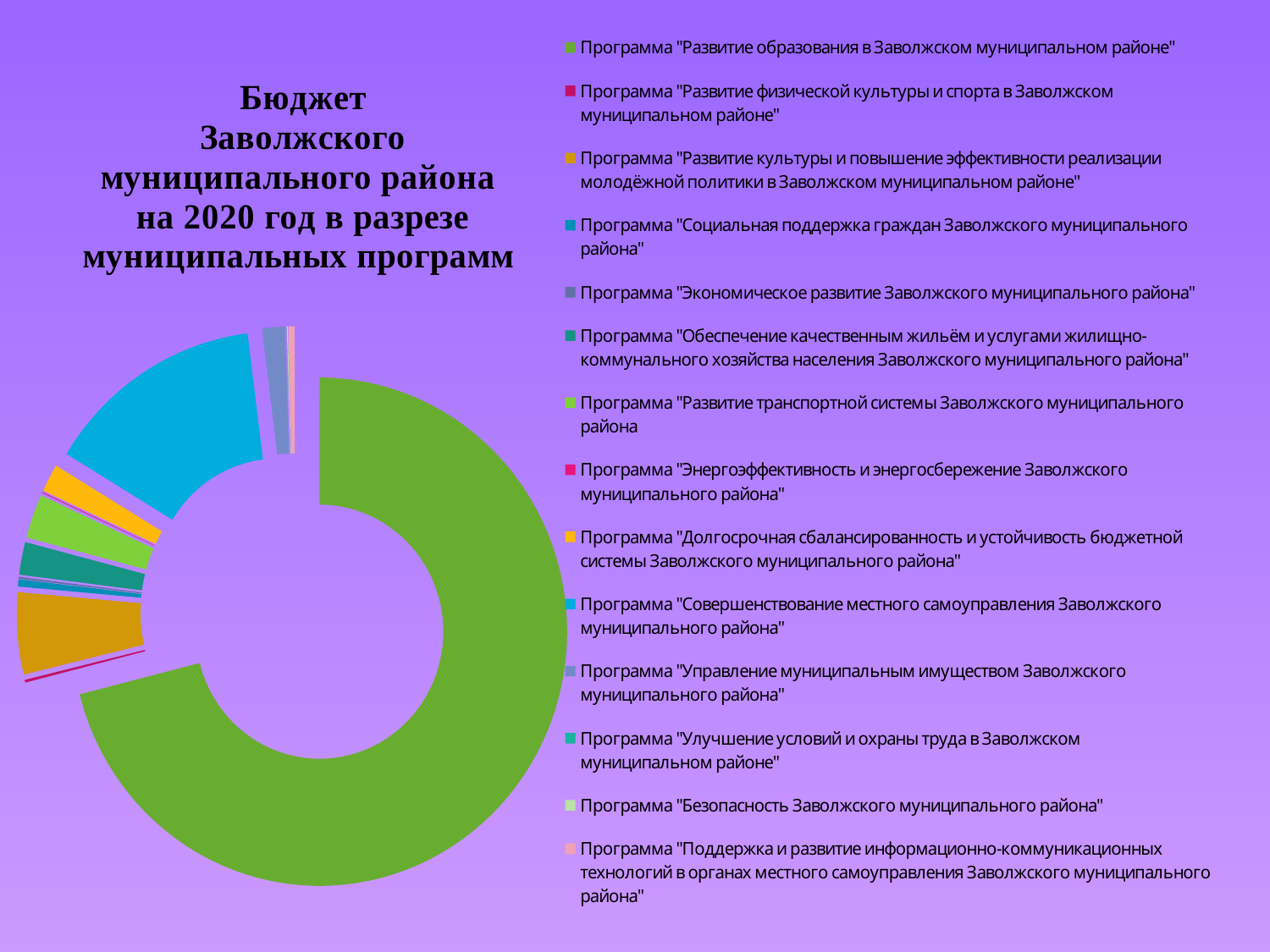
For which year does the chart show the budget? 2020 Which program is listed first in the legend? Программа "Развитие образования в Заволжском муниципальном районе" Which is larger: the share for Программа "Социальная поддержка граждан Заволжского муниципального района" or the share for Программа "Развитие культуры и повышение эффективности реализации молодёжной политики в Заволжском муниципальном районе"? Программа "Развитие культуры и повышение эффективности реализации молодёжной политики в Заволжском муниципальном районе" Which program is represented by the green colour in the chart? Программа "Развитие образования в Заволжском муниципальном районе" What kind of chart is shown on the slide? Doughnut (pie) chart Does the largest slice of the chart take up more or less than half of the doughnut? More Which program has the largest share of the budget in the chart? Программа "Развитие образования в Заволжском муниципальном районе" How many programs (categories) does the legend list? 14 Which is larger: the share for Программа "Развитие образования в Заволжском муниципальном районе" or the share for Программа "Социальная поддержка граждан Заволжского муниципального района"? Программа "Развитие образования в Заволжском муниципальном районе"